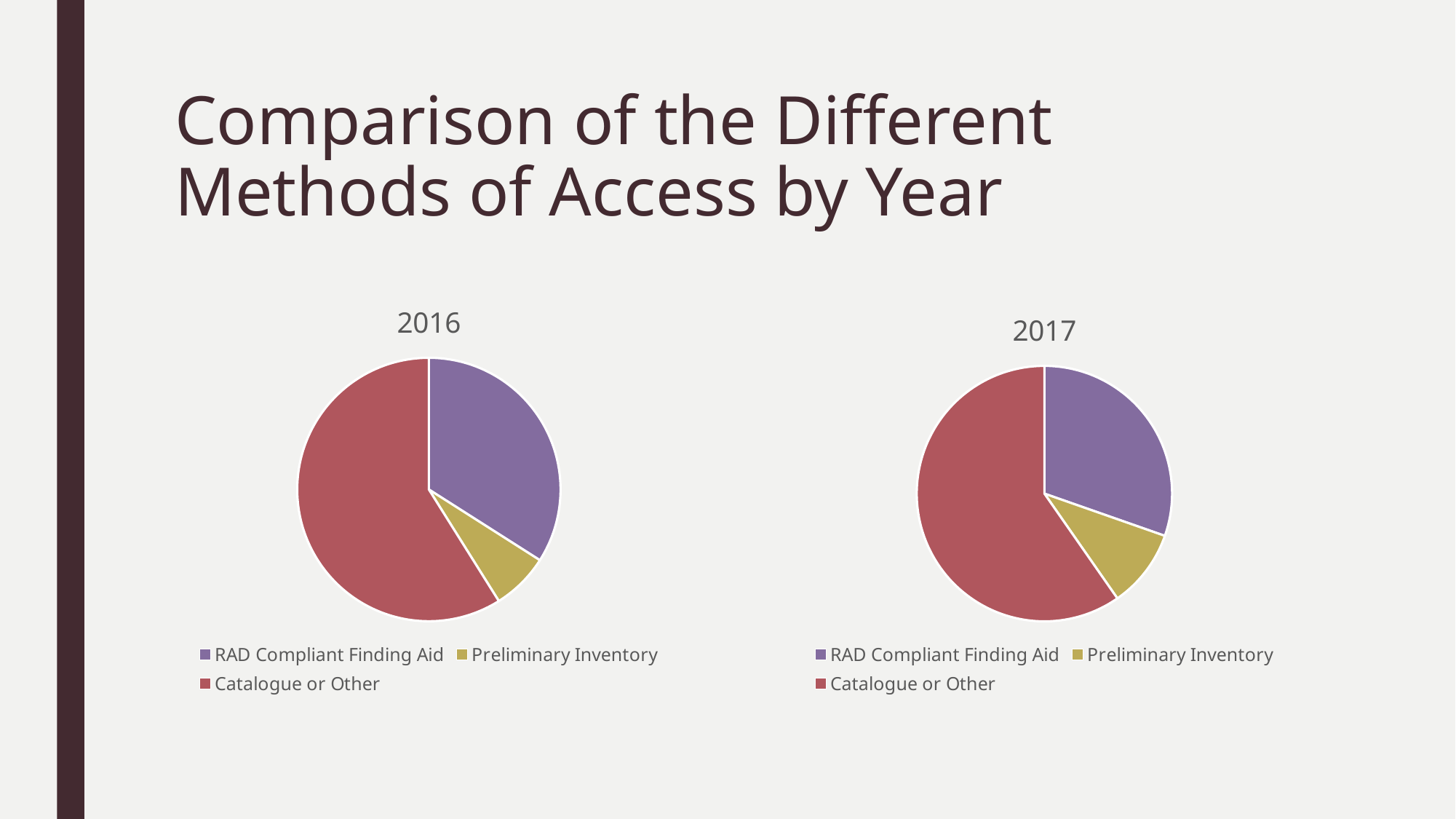
How many slices does the 2016 pie chart have? 3 In the 2016 chart, which category has the smallest slice? Preliminary Inventory In the 2016 chart, which slice is larger: RAD Compliant Finding Aid or Preliminary Inventory? RAD Compliant Finding Aid How many entries does the legend of the 2017 chart list? 3 In the 2017 chart, which category has the smallest slice? Preliminary Inventory In the 2017 chart, which category has the largest slice? Catalogue or Other What is the title of the slide containing the two pie charts? Comparison of the Different Methods of Access by Year In the 2016 chart, what colour represents Preliminary Inventory? yellow In the 2017 chart, which slice is larger: Catalogue or Other or RAD Compliant Finding Aid? Catalogue or Other What kind of chart is the 2017 chart? pie chart What kind of chart is the 2016 chart? pie chart In the 2016 chart, which category has the largest slice? Catalogue or Other